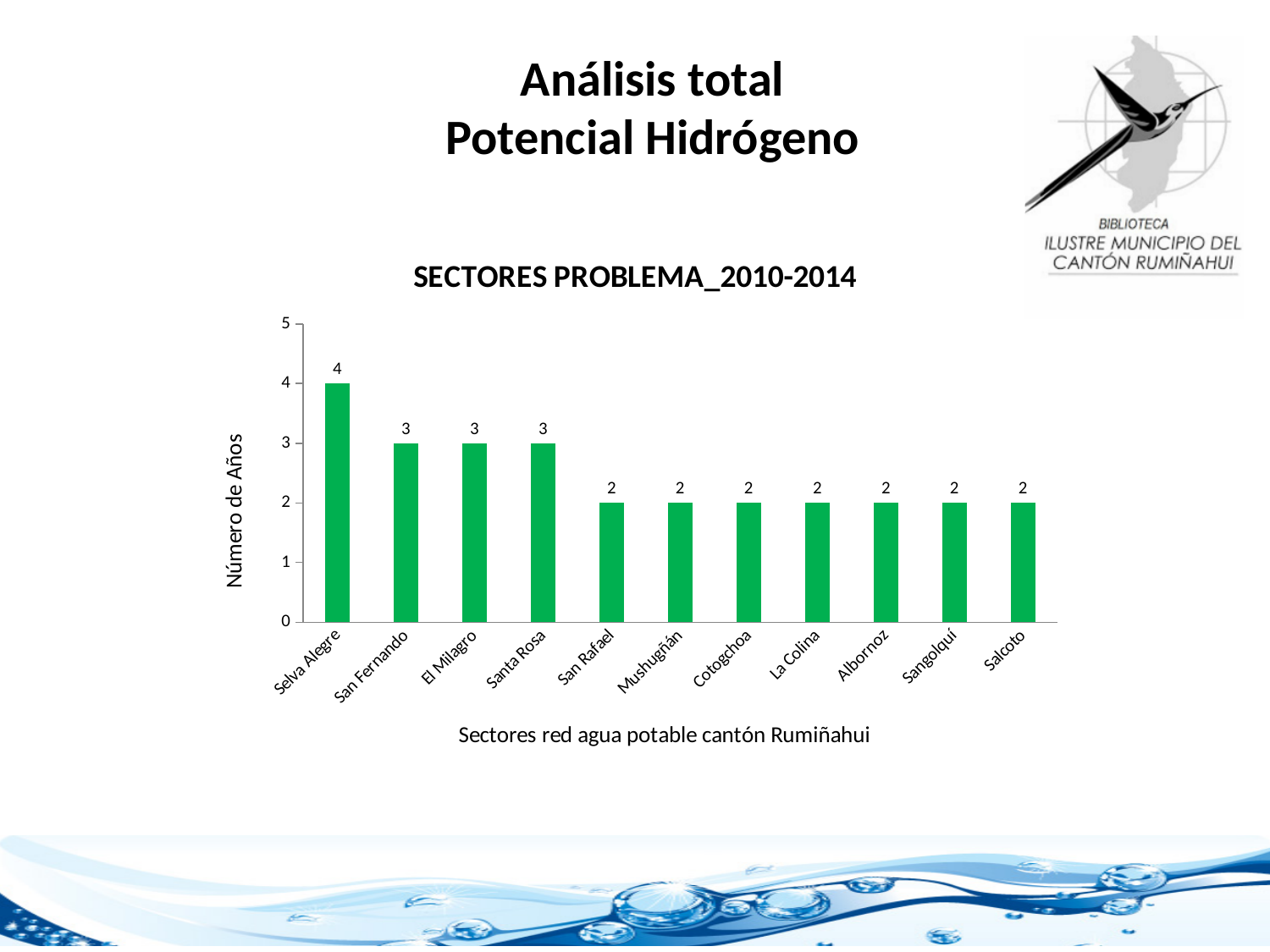
How many sectors are shown on the x axis? 11 What is the difference between the values for Santa Rosa and Cotogchoa? 1 What is the title of the chart? SECTORES PROBLEMA_2010-2014 What is the label of the vertical axis? Número de Años What is the difference between the values for Selva Alegre and San Rafael? 2 What is the value for Selva Alegre? 4 What is the value for San Fernando? 3 Which is larger, the value for El Milagro or the value for La Colina? El Milagro Do the values rise or fall from left to right along the x axis? Fall What is the value for Salcoto? 2 What kind of chart is this? Bar chart Which sector has the highest number of years? Selva Alegre